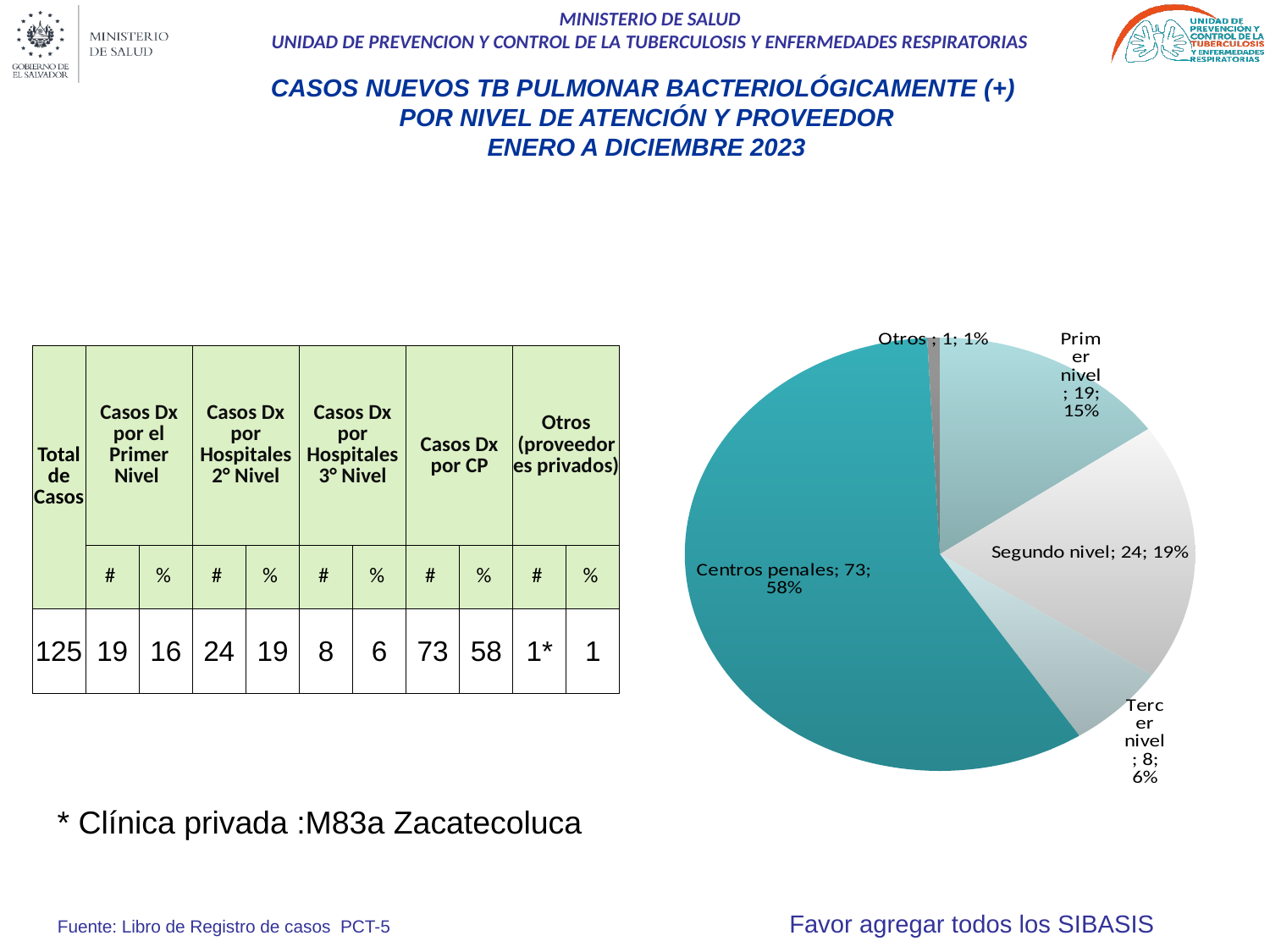
Which is larger in the pie chart, Tercer nivel or Primer nivel? Primer nivel What is the value for Segundo nivel in the pie chart? 24 How many slices does the pie chart have? 5 What is the value for Primer nivel in the pie chart? 19 What share of the pie does Centros penales represent? 58% What share of the pie does Segundo nivel represent? 19% What is the value for Tercer nivel in the pie chart? 8 Which slice of the pie chart is the largest? Centros penales What is the value for Centros penales in the pie chart? 73 What is the difference between the values for Segundo nivel and Primer nivel in the pie chart? 5 What kind of chart is shown on the slide? pie chart Which slice of the pie chart is the smallest? Otros